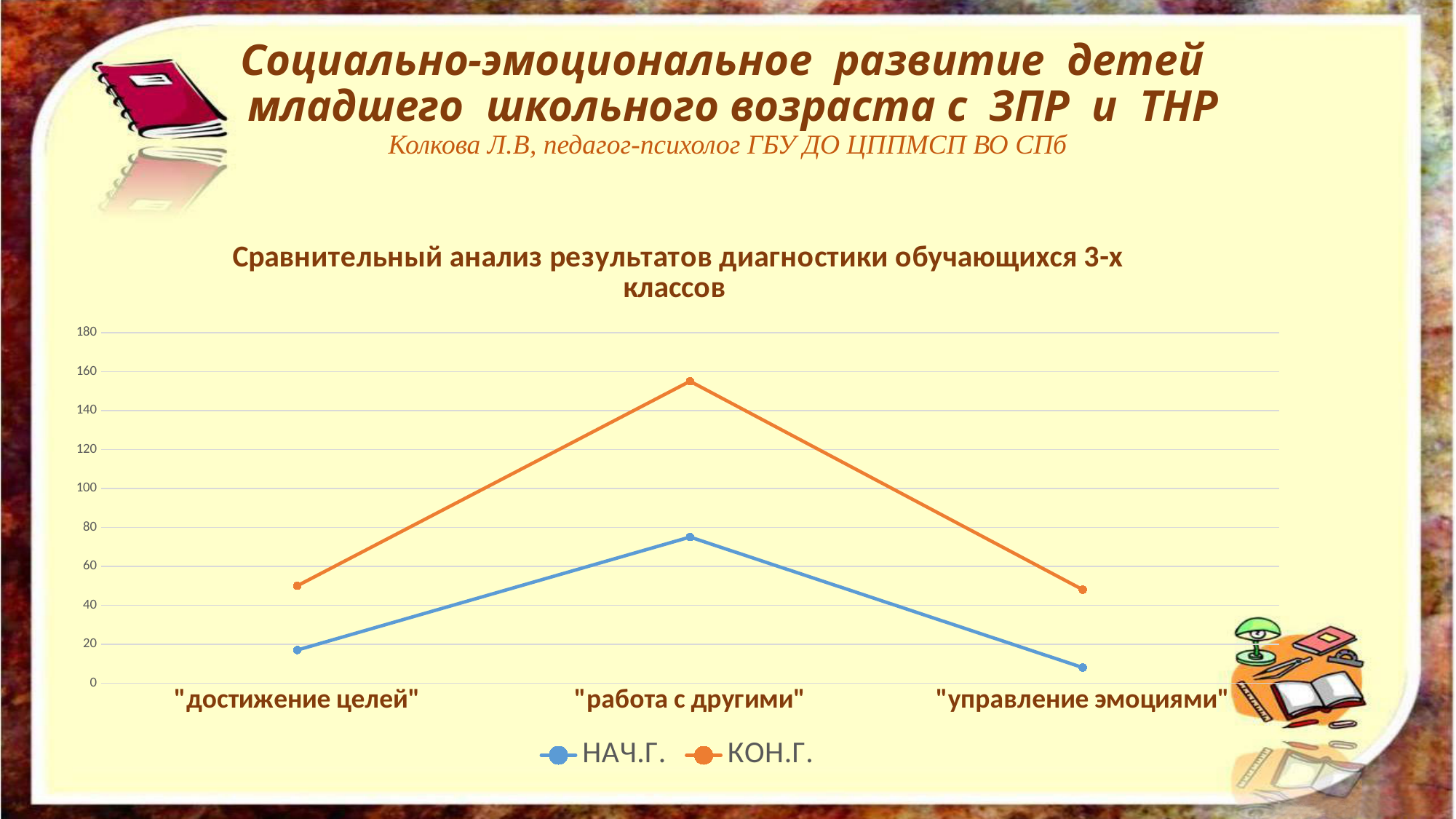
How many series does the legend list? 2 What is the title of the chart? Сравнительный анализ результатов диагностики обучающихся 3-х классов How many categories are shown on the x axis? 3 Is the НАЧ.Г. value for "работа с другими" greater or less than 60? greater For which category is the НАЧ.Г. value lowest? "управление эмоциями" For which category is the КОН.Г. value highest? "работа с другими" Is the КОН.Г. value for "работа с другими" greater or less than 140? greater For "достижение целей", which series has the larger value, НАЧ.Г. or КОН.Г.? КОН.Г. Is the НАЧ.Г. value for "управление эмоциями" greater or less than 20? less Does the КОН.Г. line rise or fall from "работа с другими" to "управление эмоциями"? fall What kind of chart is shown on the slide? line chart Which series is drawn in orange? КОН.Г.